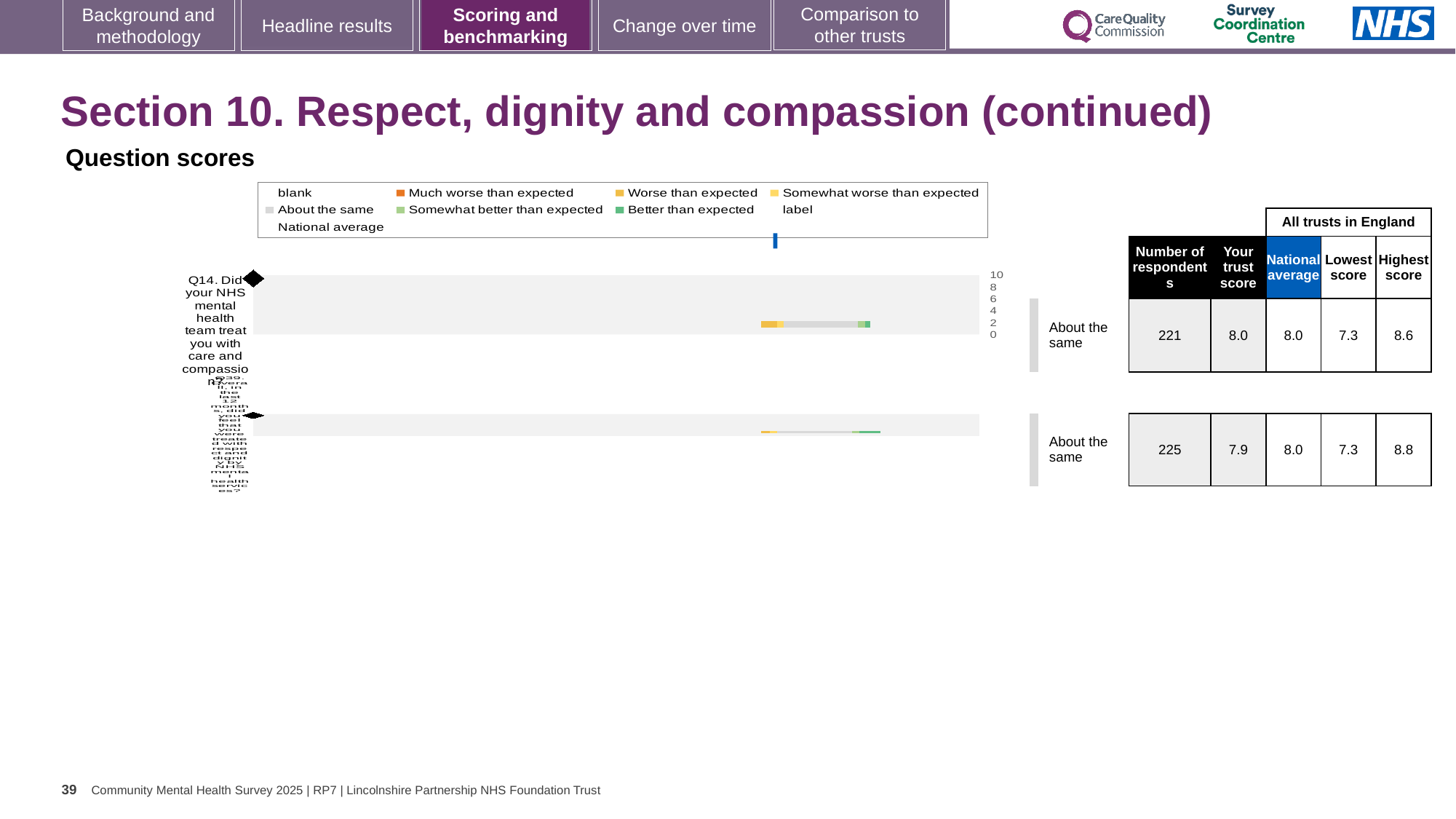
Which question has the higher trust score, Q14 or the second question (Q39)? Q14 What is the trust's score for the second question shown (Q39)? 7.9 How many questions are plotted in the question scores chart? 2 What is the difference between the highest and lowest scores for the second question shown (Q39)? 1.5 What is the national average score for Q14? 8.0 What kind of chart is used to show the question scores? Bar chart What is the highest score among all trusts in England for Q14? 8.6 What is the lowest score among all trusts in England for Q14? 7.3 What is the trust's score for Q14? 8.0 What benchmark category is shown next to the bar for Q14? About the same What is the highest score among all trusts in England for the second question shown (Q39)? 8.8 How many respondents answered Q14 (Did your NHS mental health team treat you with care and compassion?)? 221